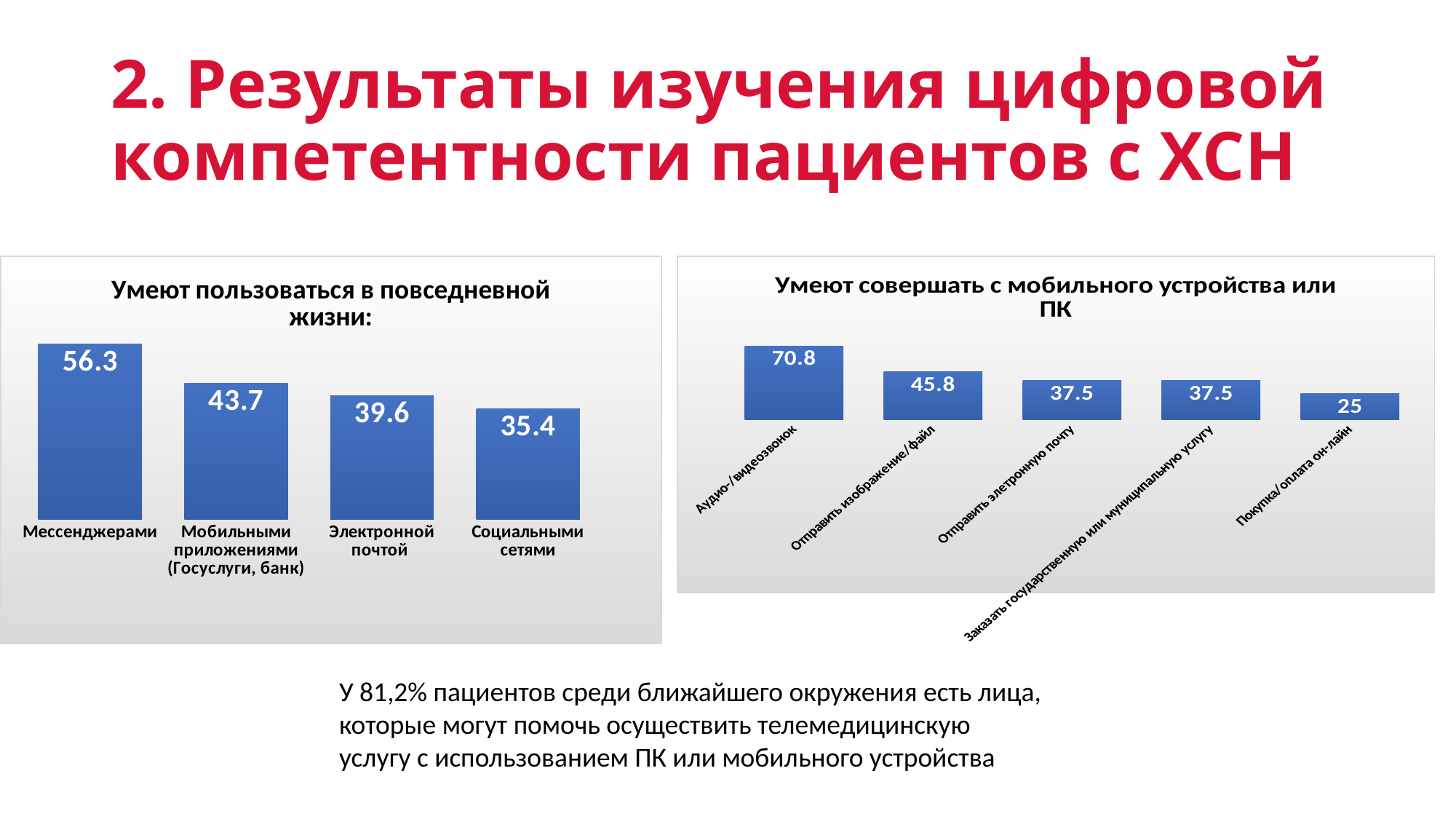
In the left chart 'Умеют пользоваться в повседневной жизни', how many categories are shown? 4 Which is larger: 'Мобильными приложениями (Госуслуги, банк)' in the left chart or 'Отправить изображение/файл' in the right chart? Отправить изображение/файл In the left chart 'Умеют пользоваться в повседневной жизни', what is the difference between 'Мессенджерами' and 'Электронной почтой'? 16.7 In the right chart 'Умеют совершать с мобильного устройства или ПК', which category has the highest value? Аудио-/видеозвонок In the right chart 'Умеют совершать с мобильного устройства или ПК', what is the difference between 'Аудио-/видеозвонок' and 'Отправить изображение/файл'? 25 In the left chart 'Умеют пользоваться в повседневной жизни', what is the value for 'Мессенджерами'? 56.3 In the left chart 'Умеют пользоваться в повседневной жизни', which category has the lowest value? Социальными сетями In the right chart 'Умеют совершать с мобильного устройства или ПК', what is the value for 'Покупка/оплата он-лайн'? 25 In the right chart 'Умеют совершать с мобильного устройства или ПК', what is the value for 'Аудио-/видеозвонок'? 70.8 What type of chart is the left chart 'Умеют пользоваться в повседневной жизни'? Bar chart In the left chart 'Умеют пользоваться в повседневной жизни', what is the value for 'Социальными сетями'? 35.4 In the right chart 'Умеют совершать с мобильного устройства или ПК', how many categories are shown? 5